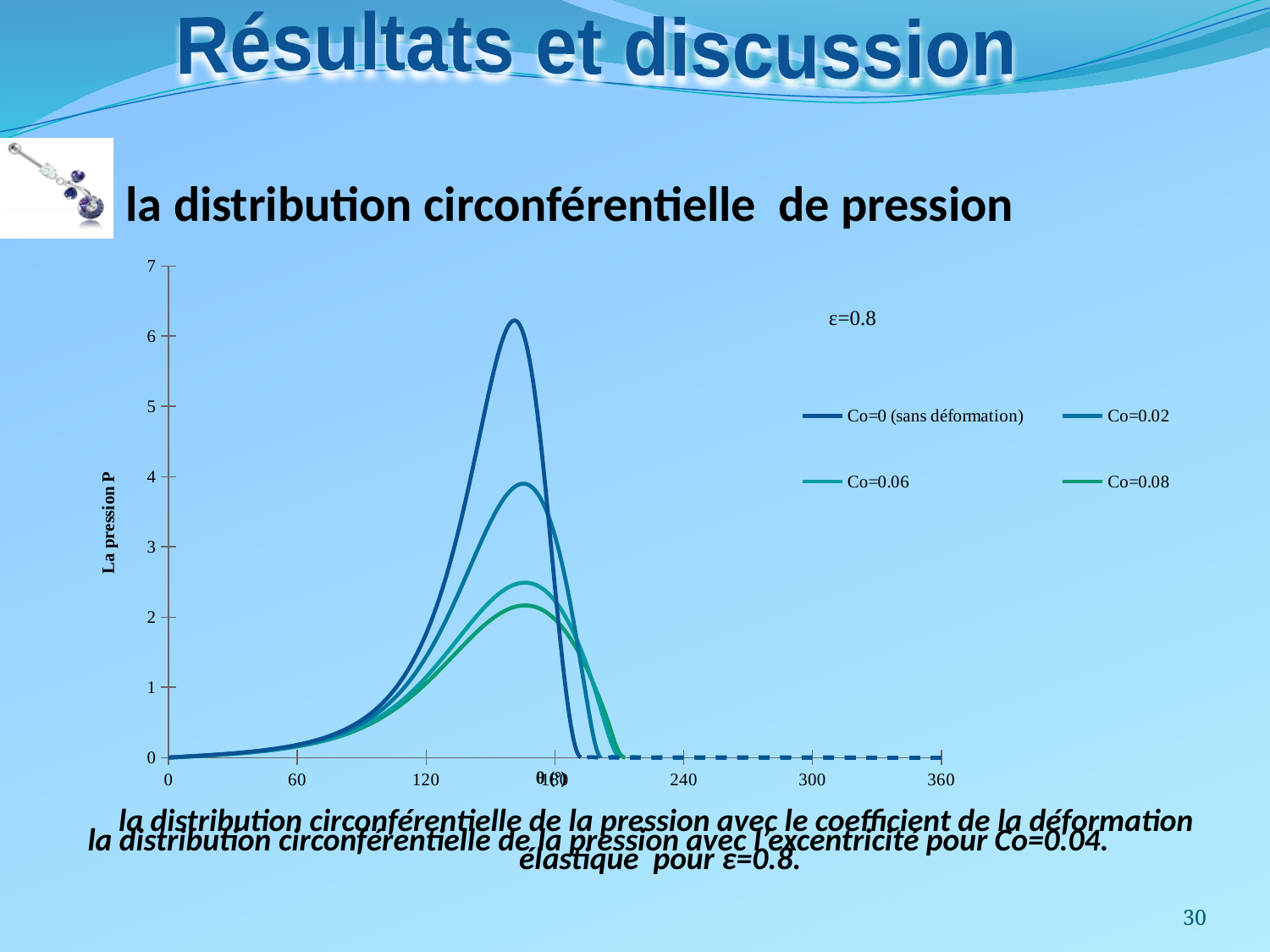
What kind of chart is shown on the slide? line chart What is the maximum value shown on the horizontal axis? 360 Which series has a higher peak, Co=0.02 or Co=0.06? Co=0.02 What is the label of the vertical axis? La pression P Which series reaches the highest peak pressure? Co=0 (sans déformation) How many series does the legend list? 4 Is the peak value of the Co=0 (sans déformation) series greater or less than 5? greater Between θ=0 and θ=120, does the Co=0 (sans déformation) curve rise or fall? rise Is the peak value of the Co=0.08 series greater or less than 3? less Which series has the lowest peak pressure? Co=0.08 Is the peak value of the Co=0.02 series greater or less than 3? greater